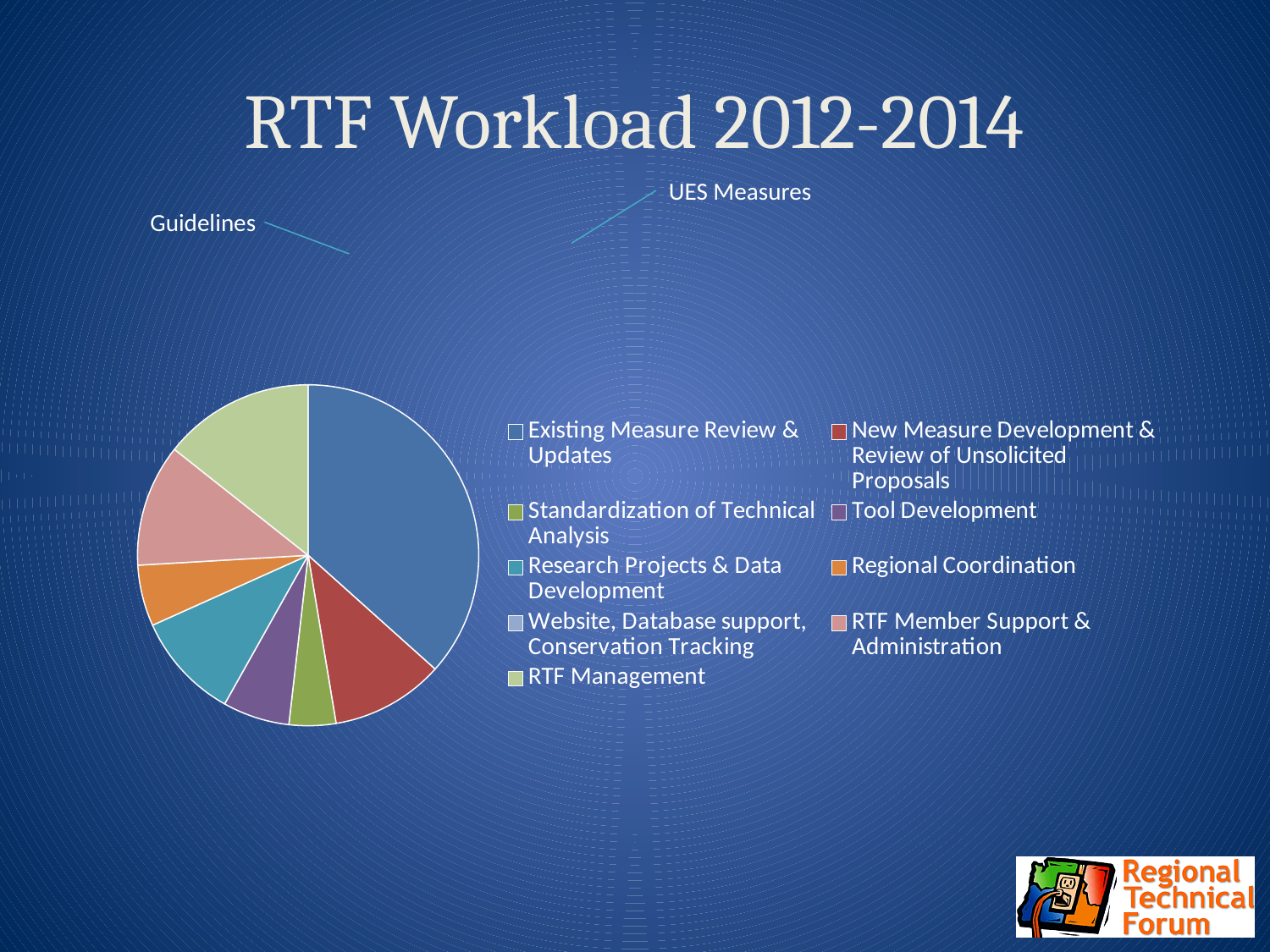
What colour is the slice for Existing Measure Review & Updates in the pie chart? Blue What is the title of the slide containing the pie chart? RTF Workload 2012-2014 How many categories does the pie chart's legend list? 9 Which slice is larger: RTF Management or Regional Coordination? RTF Management Which slice is larger: New Measure Development & Review of Unsolicited Proposals or Tool Development? New Measure Development & Review of Unsolicited Proposals Which slice is larger: Research Projects & Data Development or Tool Development? Research Projects & Data Development Which category has the largest slice of the pie chart? Existing Measure Review & Updates What kind of chart is shown on the slide? Pie chart